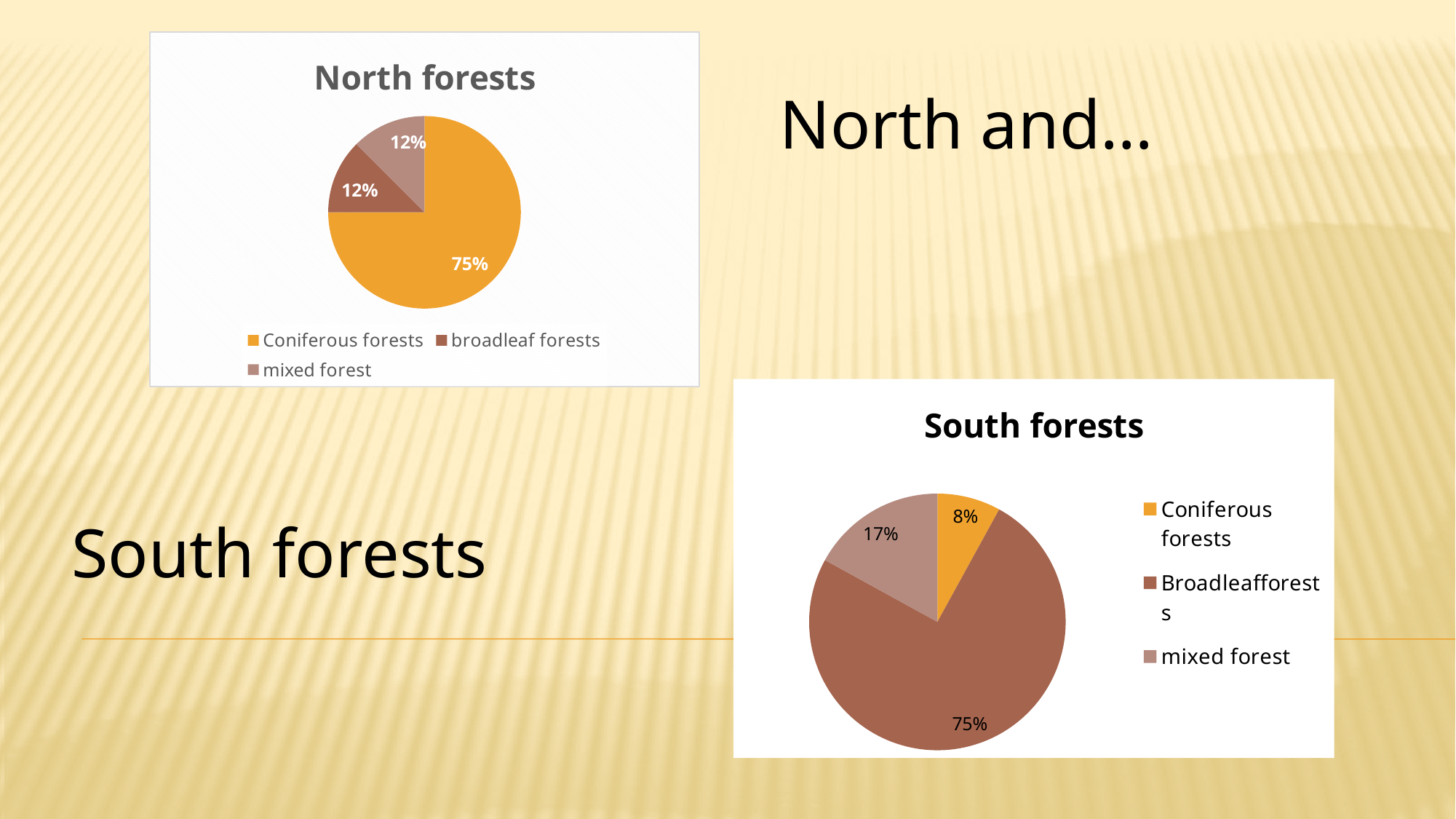
In the "South forests" chart, which forest type has the smallest slice? Coniferous forests What kind of chart is the "South forests" chart? pie chart In the "South forests" chart, which is larger: the mixed forest slice or the Coniferous forests slice? mixed forest In the "North forests" chart, what share do Coniferous forests have? 75% In the "South forests" chart, what share does mixed forest have? 17% In the "South forests" chart, what share do Coniferous forests have? 8% How many entries does the legend of the "South forests" chart list? 3 In the "North forests" chart, what share do broadleaf forests have? 12% How many slices does the "North forests" pie chart have? 3 In the "South forests" chart, what share do Broadleaf forests have? 75% In the "South forests" chart, what is the difference between the Broadleaf forests share and the mixed forest share? 58% In the "North forests" chart, which forest type has the largest slice? Coniferous forests